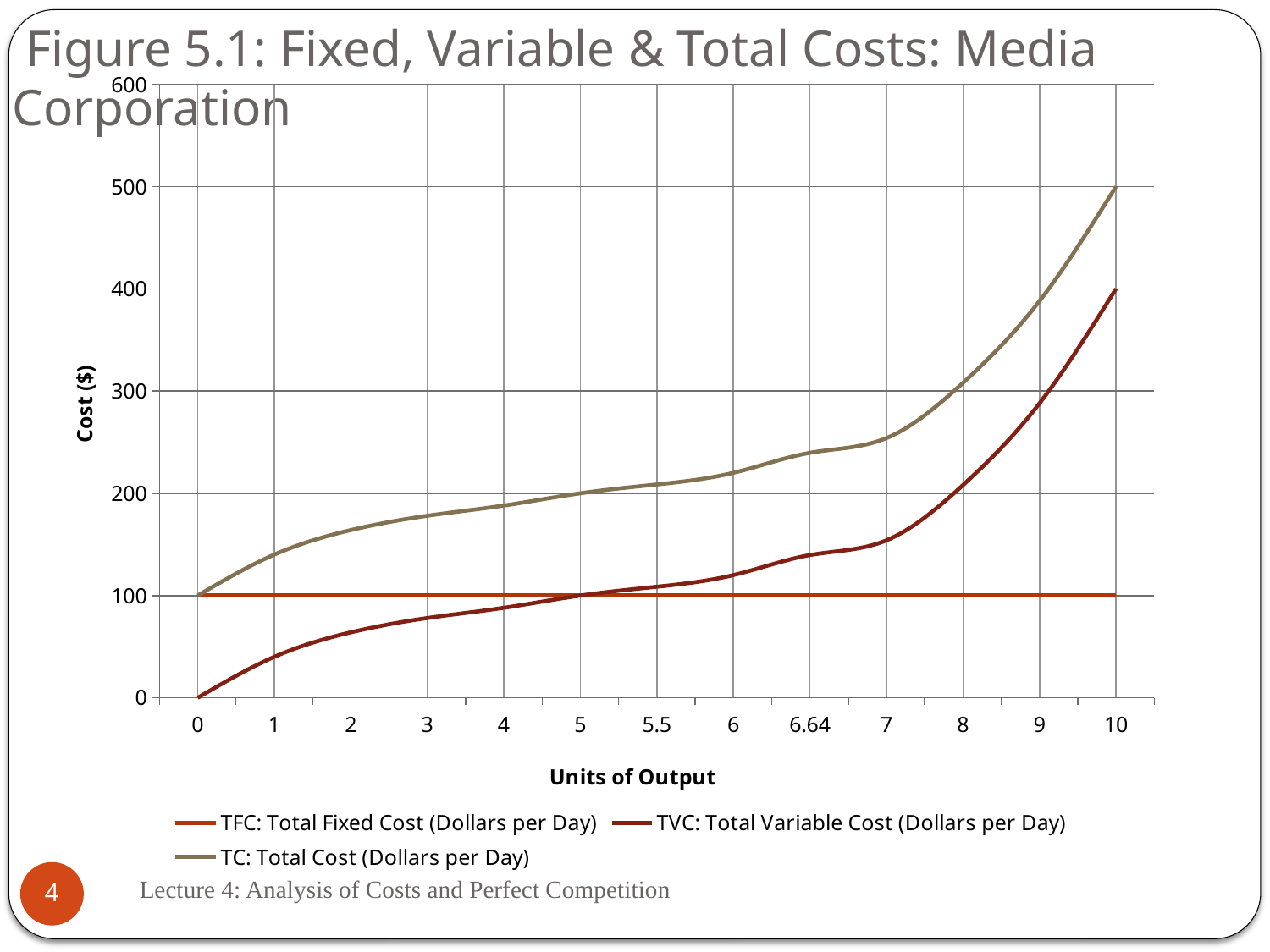
What kind of chart is shown on the slide? line chart What is the value of TFC: Total Fixed Cost at 5 units of output? 100 Is the value of TVC: Total Variable Cost at 7 units of output greater or less than 100? greater What is the difference between TC: Total Cost and TVC: Total Variable Cost at 10 units of output? 100 Which series has the highest value at 10 units of output? TC: Total Cost (Dollars per Day) What is the value of TVC: Total Variable Cost at 10 units of output? 400 Does TVC: Total Variable Cost rise or fall as units of output increase? rise What is the value of TC: Total Cost at 0 units of output? 100 Is the value of TC: Total Cost at 9 units of output greater or less than 400? less What is the value of TC: Total Cost at 10 units of output? 500 How many units-of-output points are labelled on the x axis? 13 How many series does the legend list? 3